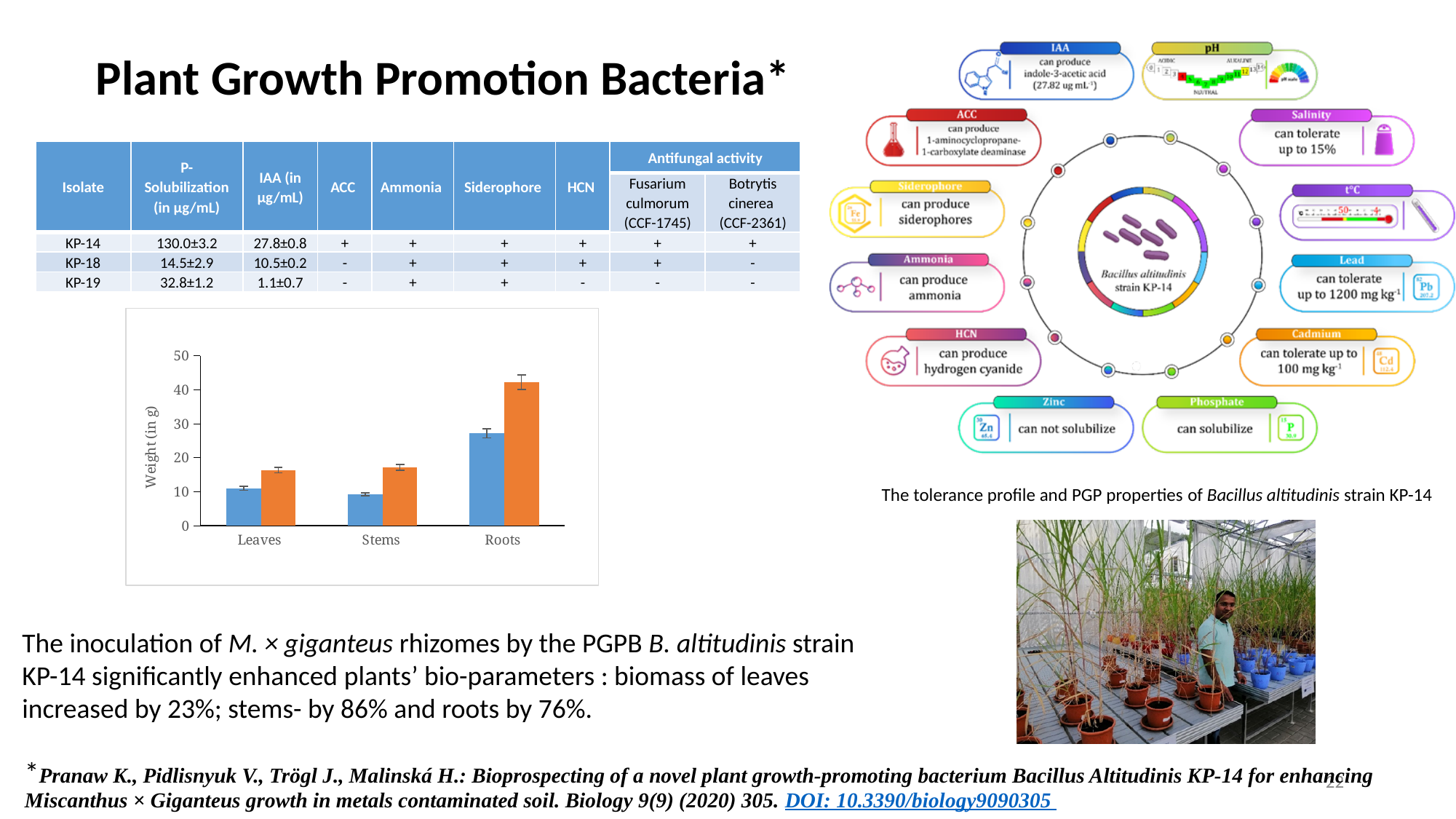
Which category has the tallest orange bar in the bar chart? Roots For Roots, which bar is taller, the blue one or the orange one? orange How many data series (bars per category) are plotted in the bar chart? 2 What kind of chart is shown on the left of the slide? bar chart Which category has the shortest blue bar in the bar chart? Stems Is the orange bar for Stems greater or less than 20? less How many categories are shown on the x axis of the bar chart? 3 Is the blue bar for Roots greater or less than 30? less Is the orange bar for Roots greater or less than 40? greater Do the orange bars rise or fall from Stems to Roots? rise What is the label of the y axis of the bar chart? Weight (in g)